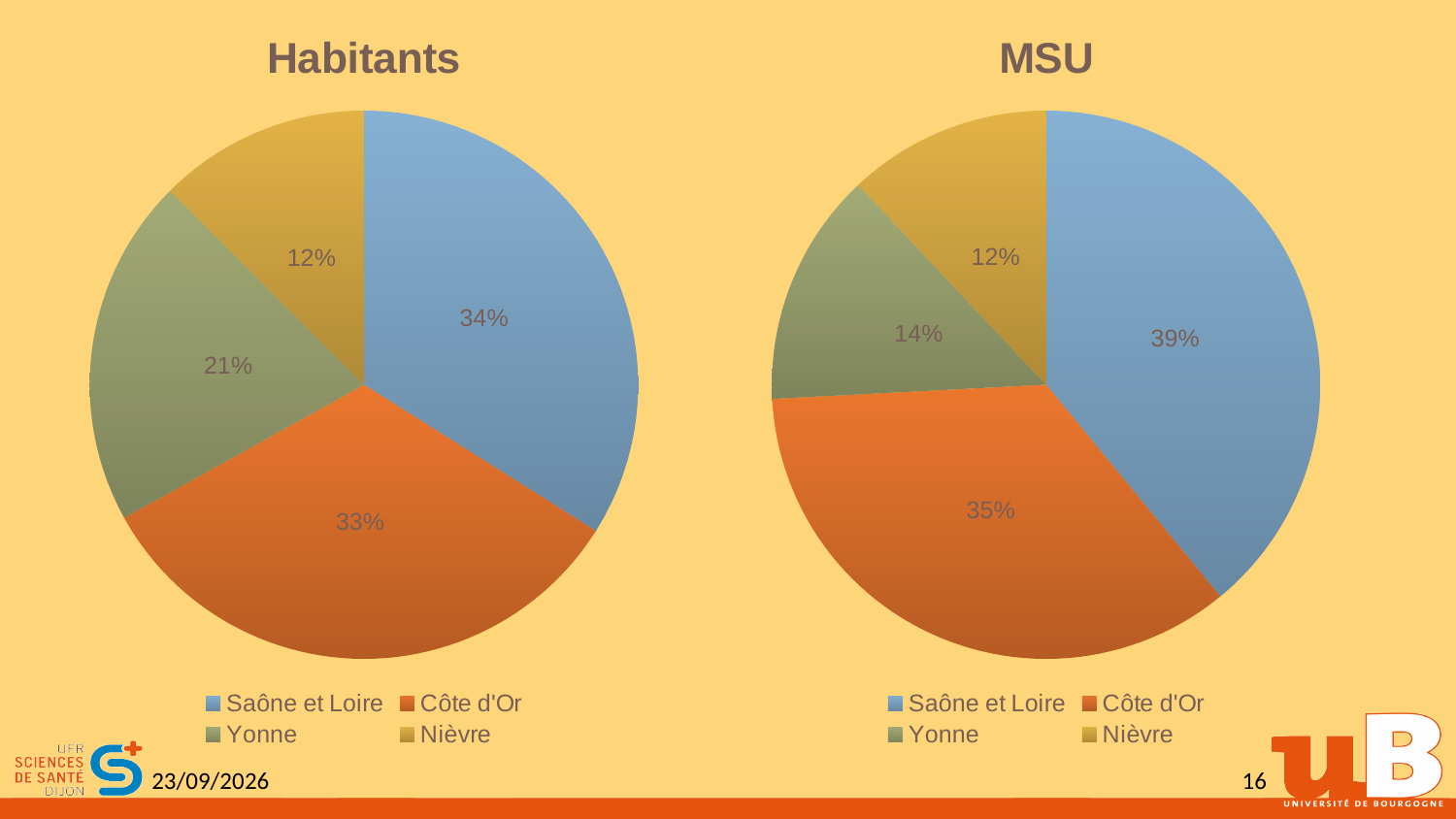
In the Habitants chart, which department has the smallest share? Nièvre In the Habitants chart, what share does Yonne have? 21% How many slices does the Habitants pie chart have? 4 In the MSU chart, what is the difference between the shares of Saône et Loire and Yonne? 25 percentage points What is the title of the chart on the left side of the slide? Habitants In the MSU chart, which department has the smallest share? Nièvre In the Habitants chart, what share does Nièvre have? 12% In the MSU chart, what share does Saône et Loire have? 39% In the MSU chart, what share does Côte d'Or have? 35% In the MSU chart, which department has the largest share? Saône et Loire In the Habitants chart, which is larger: the share of Yonne or the share of Nièvre? Yonne What type of chart is the MSU chart? Pie chart